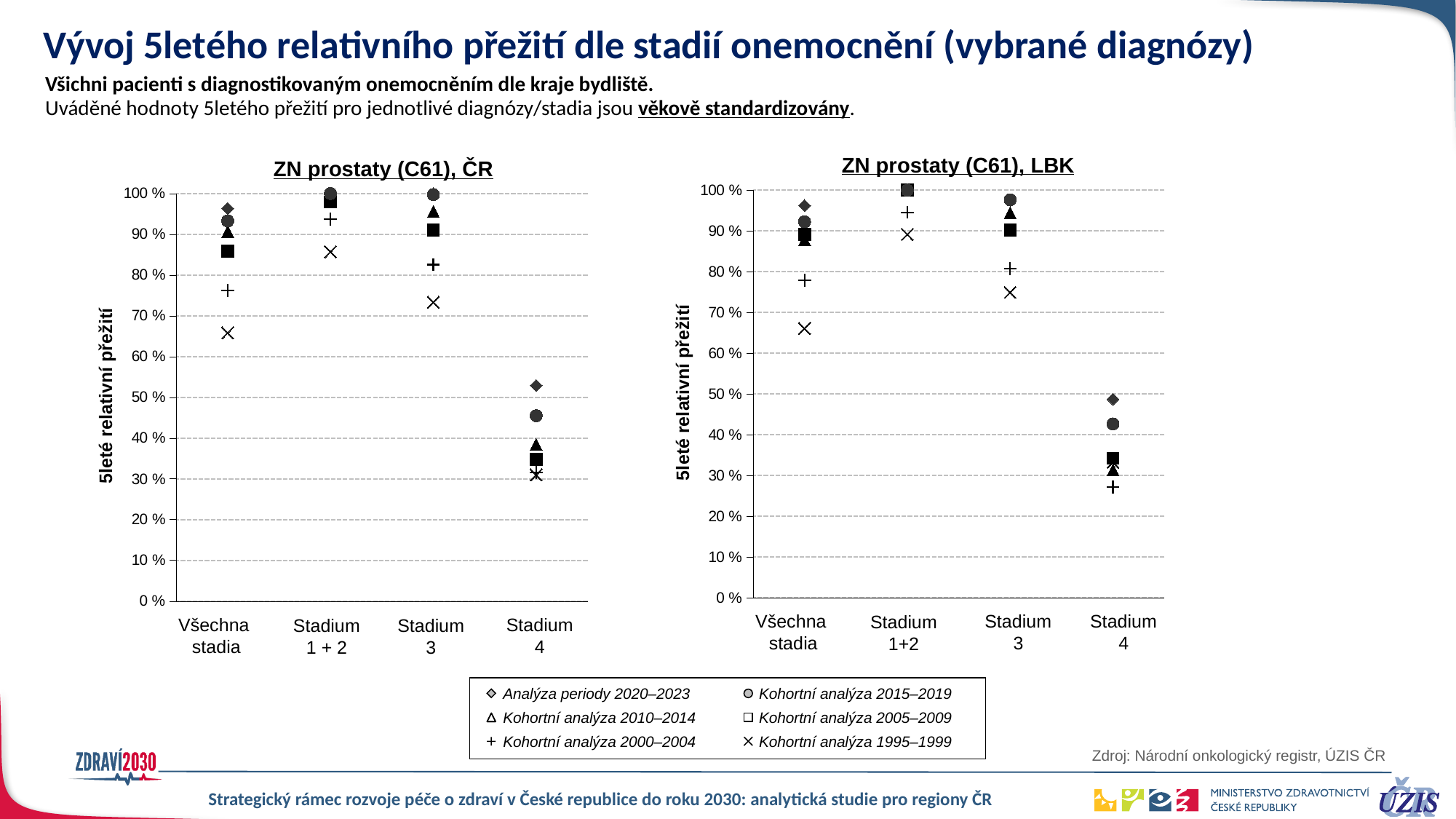
In the chart titled "ZN prostaty (C61), ČR", do the values for Analýza periody 2020–2023 rise or fall going from Stadium 1 + 2 through Stadium 3 to Stadium 4? fall In the chart titled "ZN prostaty (C61), LBK", is the value for Stadium 4 in the series Kohortní analýza 2000–2004 greater or less than 30 %? less In the chart titled "ZN prostaty (C61), ČR", how many categories are shown on the x axis? 4 What is the y-axis title of the chart titled "ZN prostaty (C61), LBK"? 5leté relativní přežití In the chart titled "ZN prostaty (C61), ČR", is the value for Stadium 4 in the series Analýza periody 2020–2023 greater or less than 50 %? greater What kind of chart is "ZN prostaty (C61), LBK"? scatter chart In the chart titled "ZN prostaty (C61), ČR", is the value for Stadium 3 in the series Kohortní analýza 2000–2004 greater or less than 80 %? greater In the chart titled "ZN prostaty (C61), ČR", for Stadium 4, which series has the larger value: Analýza periody 2020–2023 or Kohortní analýza 1995–1999? Analýza periody 2020–2023 How many series does the shared legend below the charts list? 6 In the chart titled "ZN prostaty (C61), LBK", for Všechna stadia, which series has the larger value: Kohortní analýza 1995–1999 or Analýza periody 2020–2023? Analýza periody 2020–2023